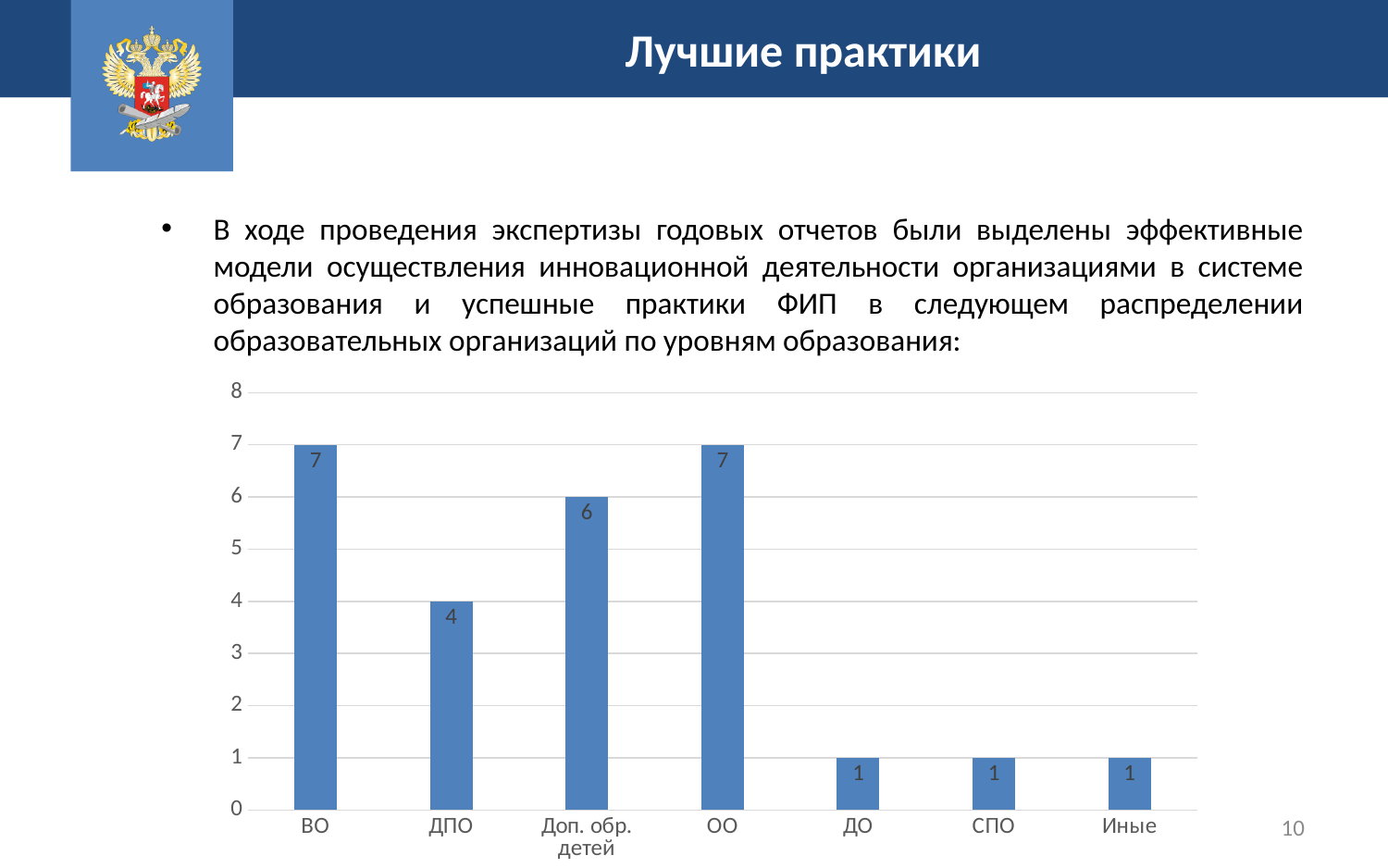
What is the maximum value shown on the y axis? 8 What is the value for СПО? 1 What kind of chart is shown on the slide? bar chart What is the value for ДПО? 4 What is the difference between the values for Доп. обр. детей and ДО? 5 Which categories have the highest value? ВО and ОО Which is larger, the value for ДПО or the value for Доп. обр. детей? Доп. обр. детей Is the value for ОО greater or less than 5? greater What is the value for Доп. обр. детей? 6 What is the difference between the values for ВО and ДПО? 3 What is the total of the values for ДО, СПО and Иные? 3 How many categories are shown on the x axis? 7